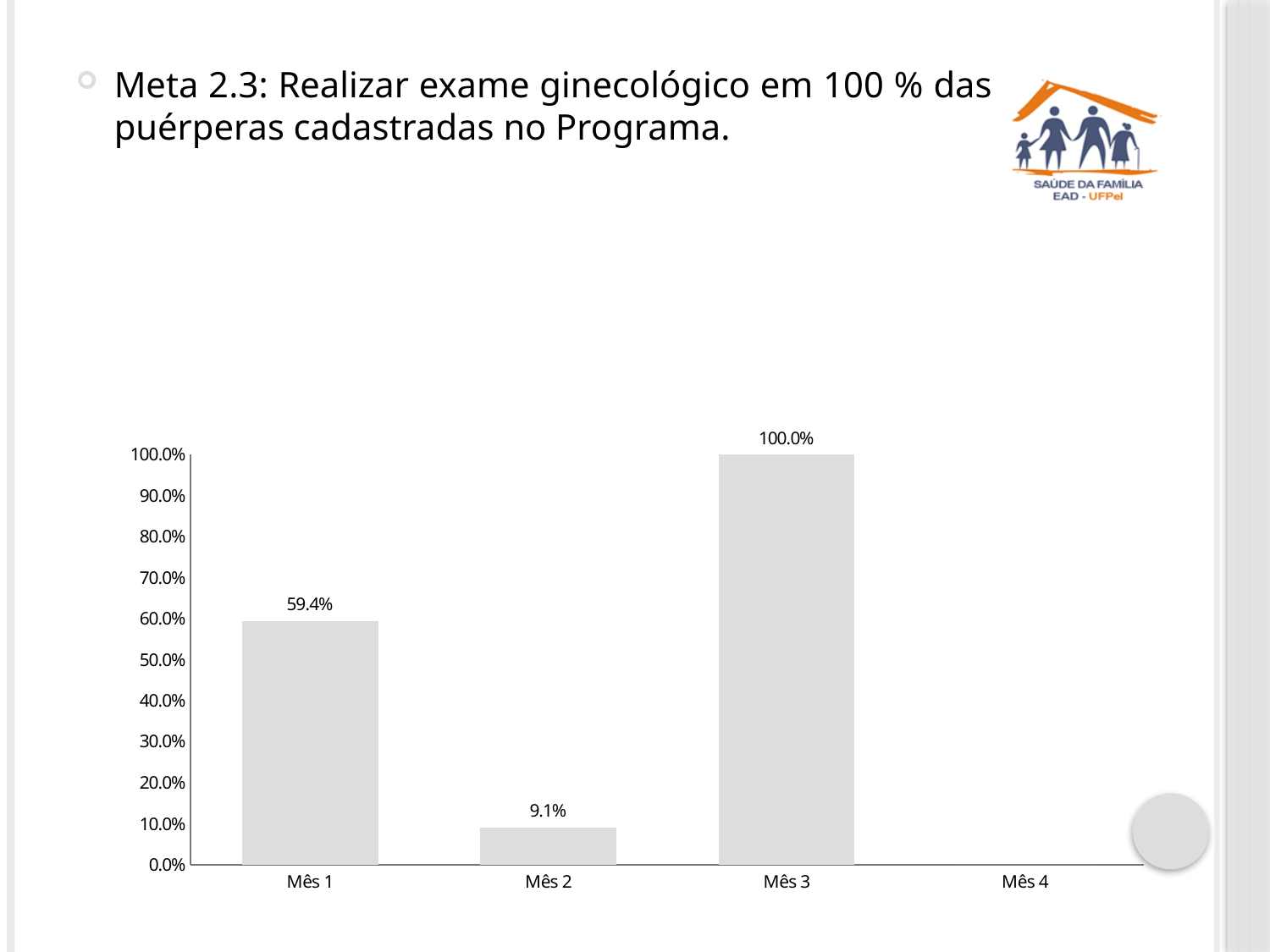
What is the value for Mês 2? 9.1% What is the difference between the values for Mês 1 and Mês 2? 50.3% What kind of chart is shown on the slide? bar chart Among the months with a plotted bar, which has the lowest value? Mês 2 Is the value for Mês 1 greater or less than 50.0%? greater What is the value for Mês 3? 100.0% Which is larger, the value for Mês 1 or the value for Mês 2? Mês 1 How many months are shown on the x axis? 4 Which month has the highest value? Mês 3 What is the value for Mês 1? 59.4% From Mês 2 to Mês 3, does the value rise or fall? rise What is the difference between the values for Mês 3 and Mês 1? 40.6%